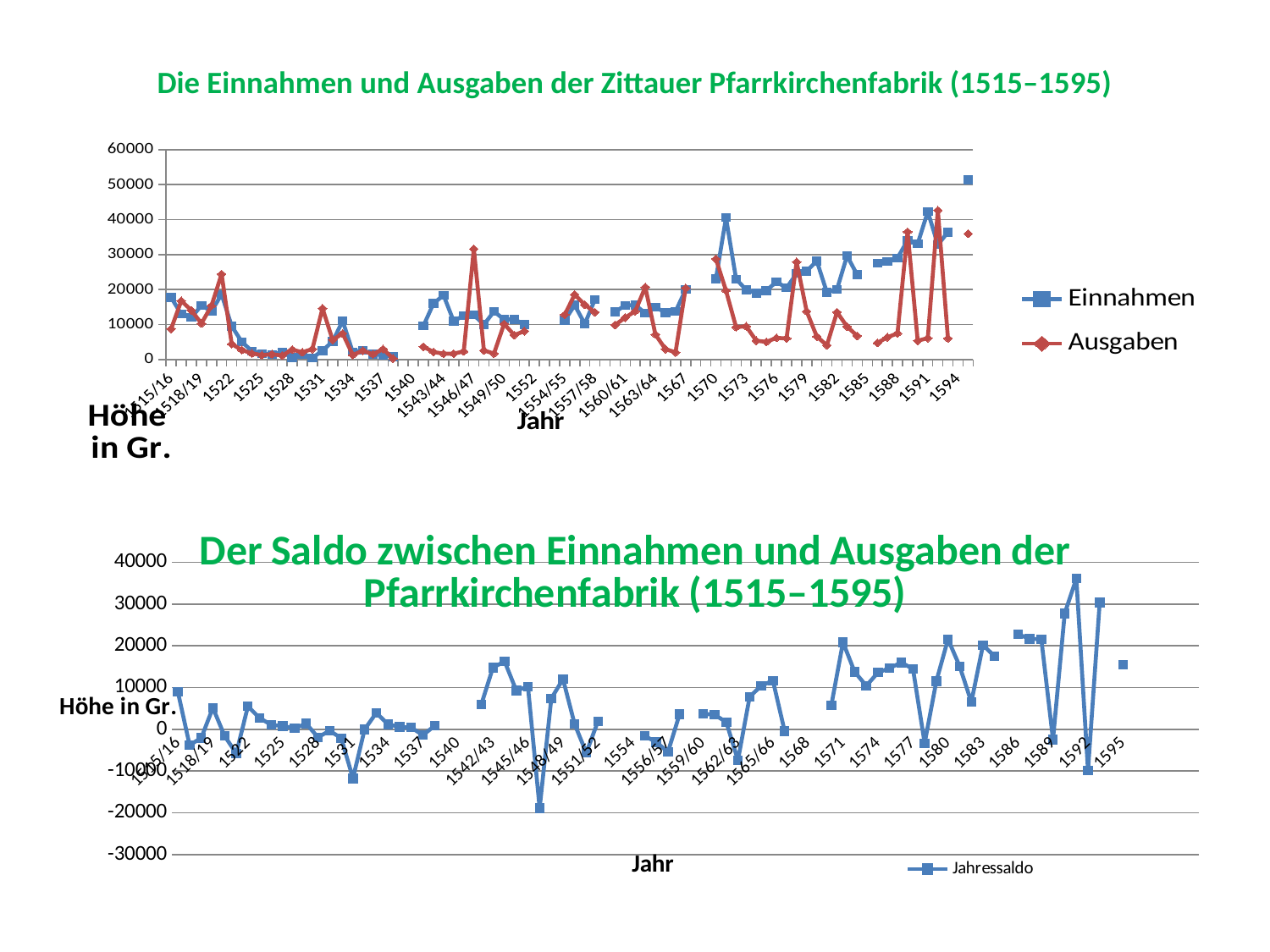
In the bottom chart, is the Jahressaldo value for 1571 greater or less than 10000? greater In the top chart, which series has the highest plotted value overall? Einnahmen What type of chart is the top chart titled 'Die Einnahmen und Ausgaben der Zittauer Pfarrkirchenfabrik (1515–1595)'? Line chart In the top chart, is the Einnahmen value for 1570 greater or less than 30000? less What is the title of the bottom chart? Der Saldo zwischen Einnahmen und Ausgaben der Pfarrkirchenfabrik (1515–1595) How many series does the legend of the top chart list? 2 In the top chart, which series is drawn with red diamond markers? Ausgaben In the bottom chart, is the Jahressaldo value for 1592 greater or less than 20000? less How many series does the legend of the bottom chart list? 1